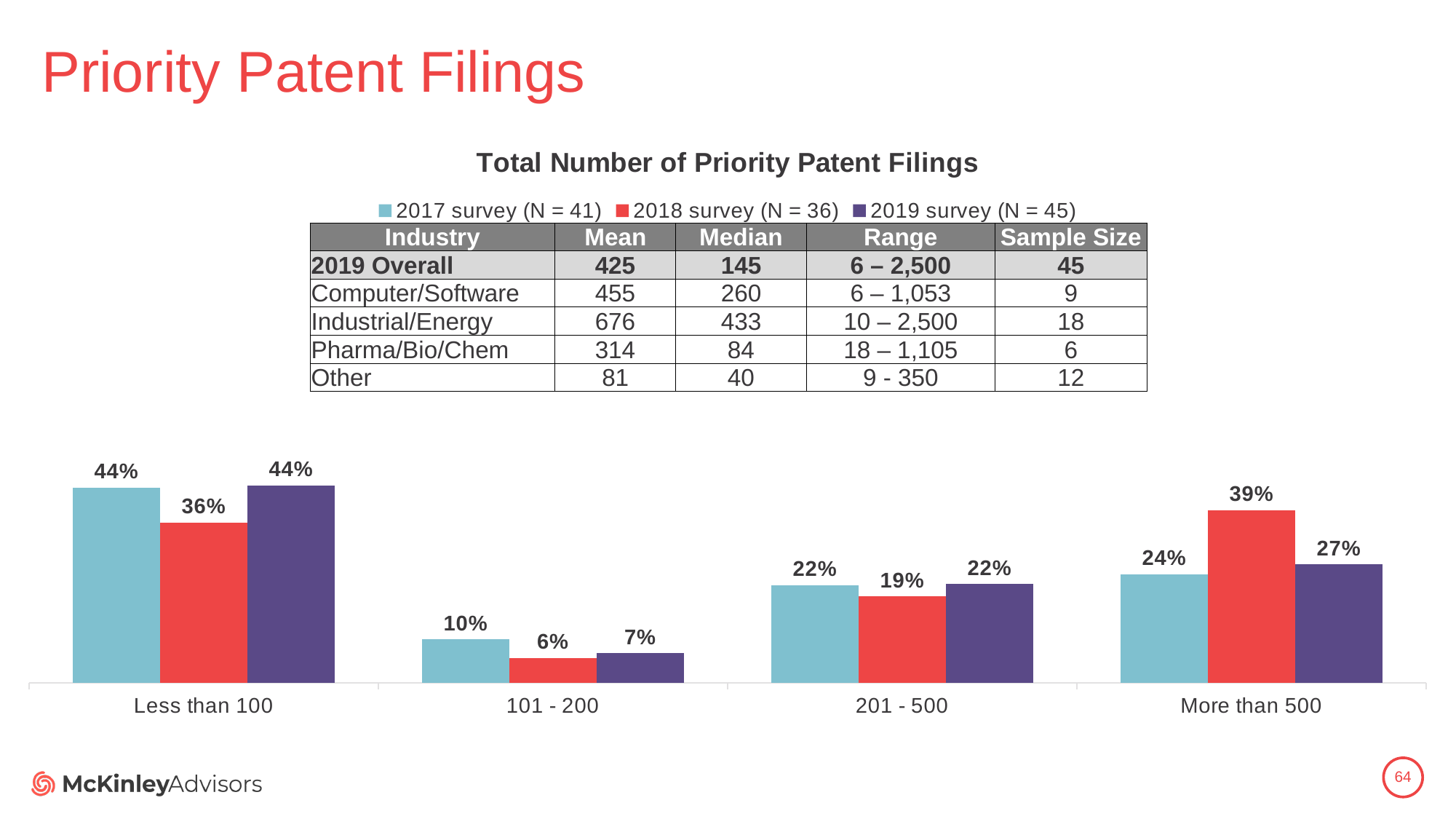
What is the value for the 2017 survey in the '101 - 200' category? 10% Which category has the lowest value for the 2019 survey? 101 - 200 How many series does the chart legend list? 3 What is the sample size (N) for the 2019 survey shown in the legend? 45 What is the title of the chart? Total Number of Priority Patent Filings What is the difference between the 2018 survey and 2017 survey values in the 'More than 500' category? 15% How many categories are shown on the x axis of the chart? 4 What is the value for the 2019 survey in the 'More than 500' category? 27% What percentage of respondents in the 2018 survey reported less than 100 priority patent filings? 36% In the 'Less than 100' category, which is larger: the 2017 survey value or the 2018 survey value? 2017 survey What kind of chart is shown on the slide? Bar chart Which category has the highest value for the 2018 survey? More than 500